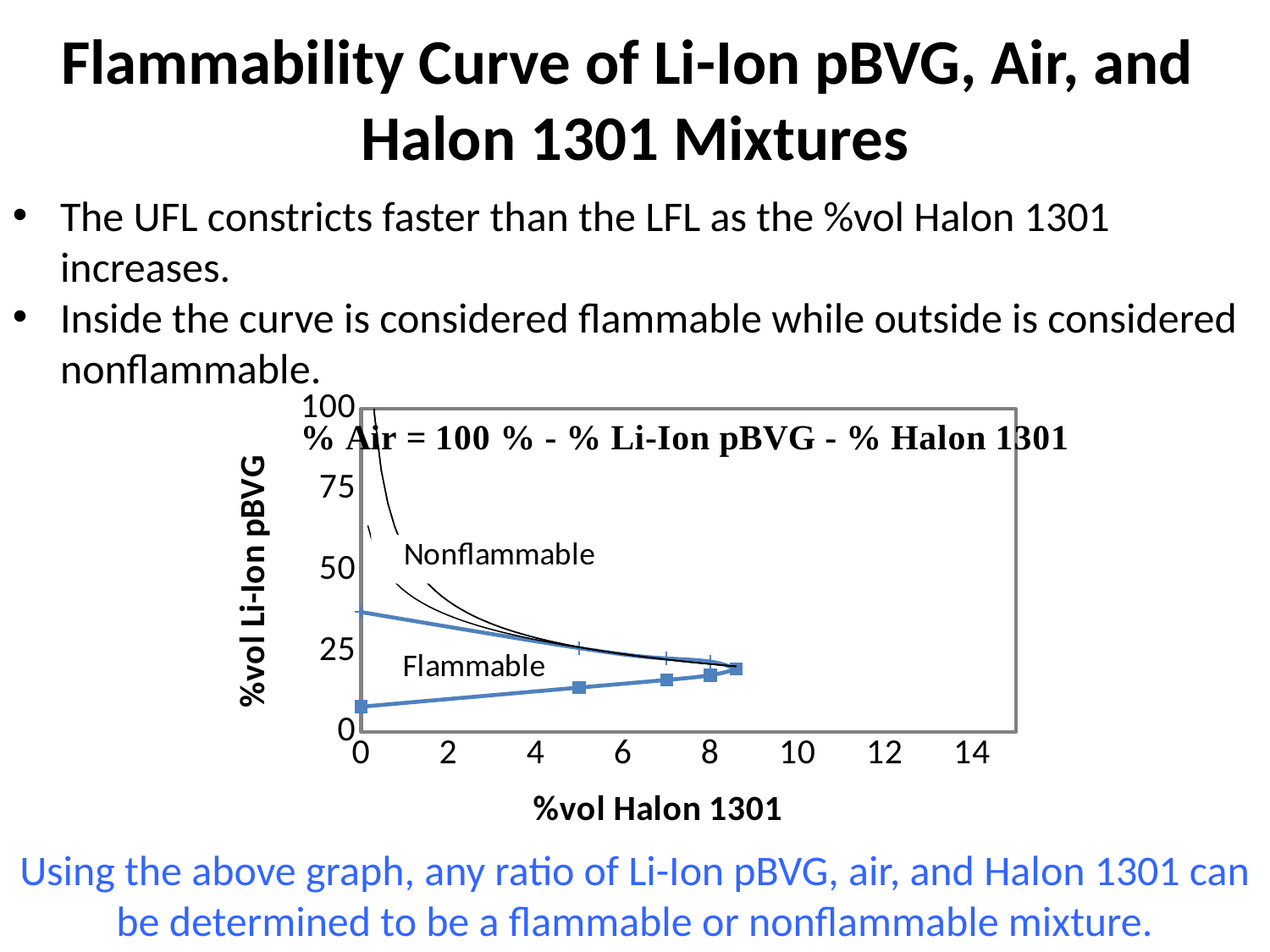
What kind of chart is shown on the slide? line chart What is the title of the x axis of the chart? %vol Halon 1301 Is the value of the upper (UFL) curve at 0 %vol Halon 1301 greater or less than 25? greater At 0 %vol Halon 1301, which curve has the larger %vol Li-Ion pBVG value, the upper (UFL) curve or the lower (LFL) curve? the upper (UFL) curve What is the highest value shown on the x axis of the chart? 14 Is the value of the lower (LFL) curve at 8 %vol Halon 1301 greater or less than 25? less Does the upper (UFL) curve rise or fall as %vol Halon 1301 increases? fall Is the value of the lower (LFL) curve at 0 %vol Halon 1301 greater or less than 25? less How many tick labels are shown on the y axis of the chart? 5 What is the title of the y axis of the chart? %vol Li-Ion pBVG Does the lower (LFL) curve rise or fall as %vol Halon 1301 increases? rise